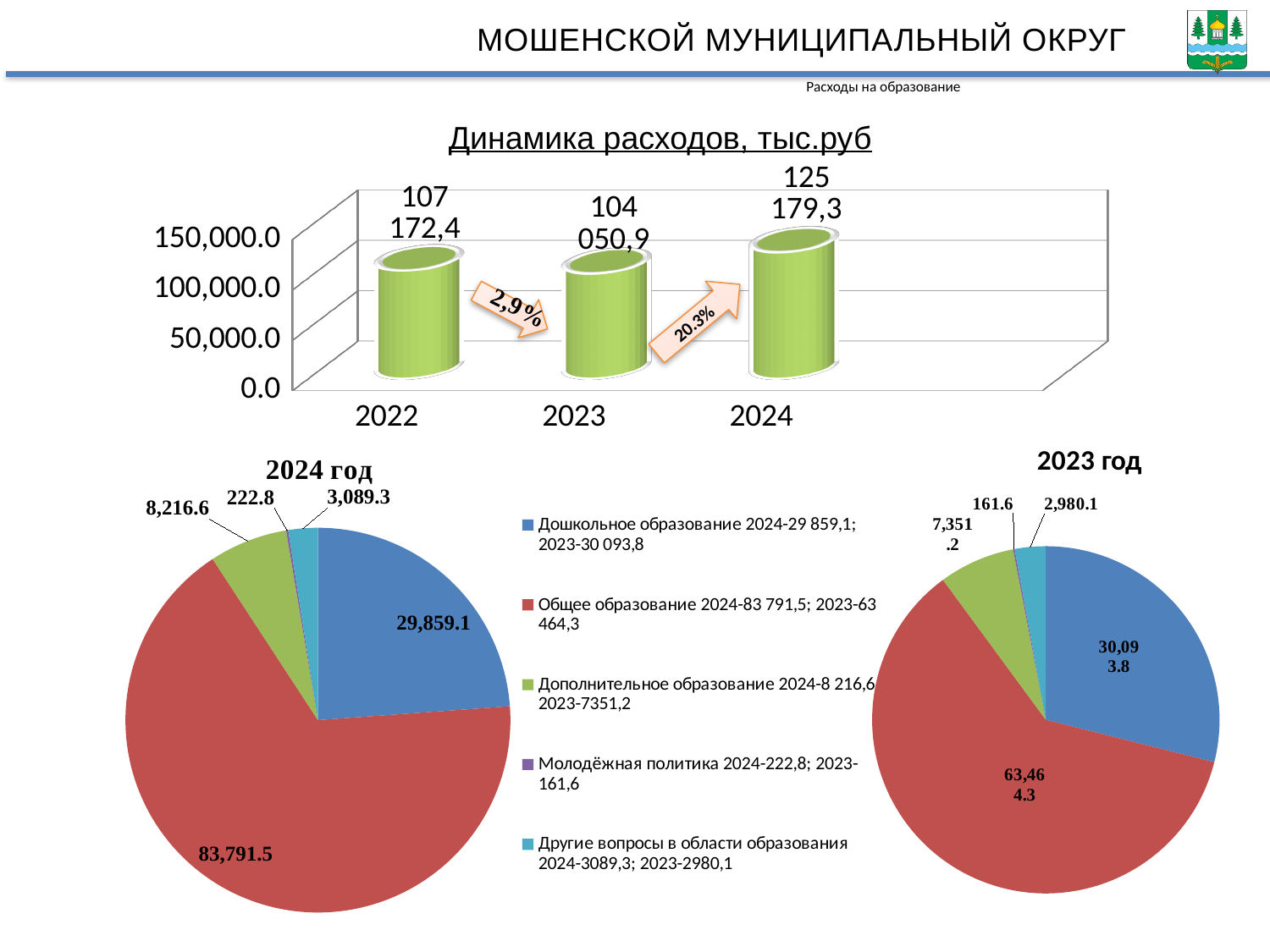
In the chart 'Динамика расходов, тыс.руб', does the value rise or fall from 2022 to 2023? fall In the pie chart '2023 год', which category has the smallest slice? Молодёжная политика In the chart 'Динамика расходов, тыс.руб', what is the value for 2022? 107 172,4 In the chart 'Динамика расходов, тыс.руб', which year has the highest value? 2024 In the chart 'Динамика расходов, тыс.руб', which year has the lowest value? 2023 In the pie chart '2023 год', what is the value for Дополнительное образование? 7,351.2 In the chart 'Динамика расходов, тыс.руб', what is the percentage change shown on the arrow between 2023 and 2024? 20.3% In the pie chart '2024 год', what is the difference between Общее образование and Дошкольное образование? 53,932.4 What kind of chart is 'Динамика расходов, тыс.руб'? bar chart In the pie chart '2024 год', what is the value for Общее образование? 83,791.5 In the chart 'Динамика расходов, тыс.руб', what is the value for 2024? 125 179,3 How many entries does the legend between the two pie charts list? 5